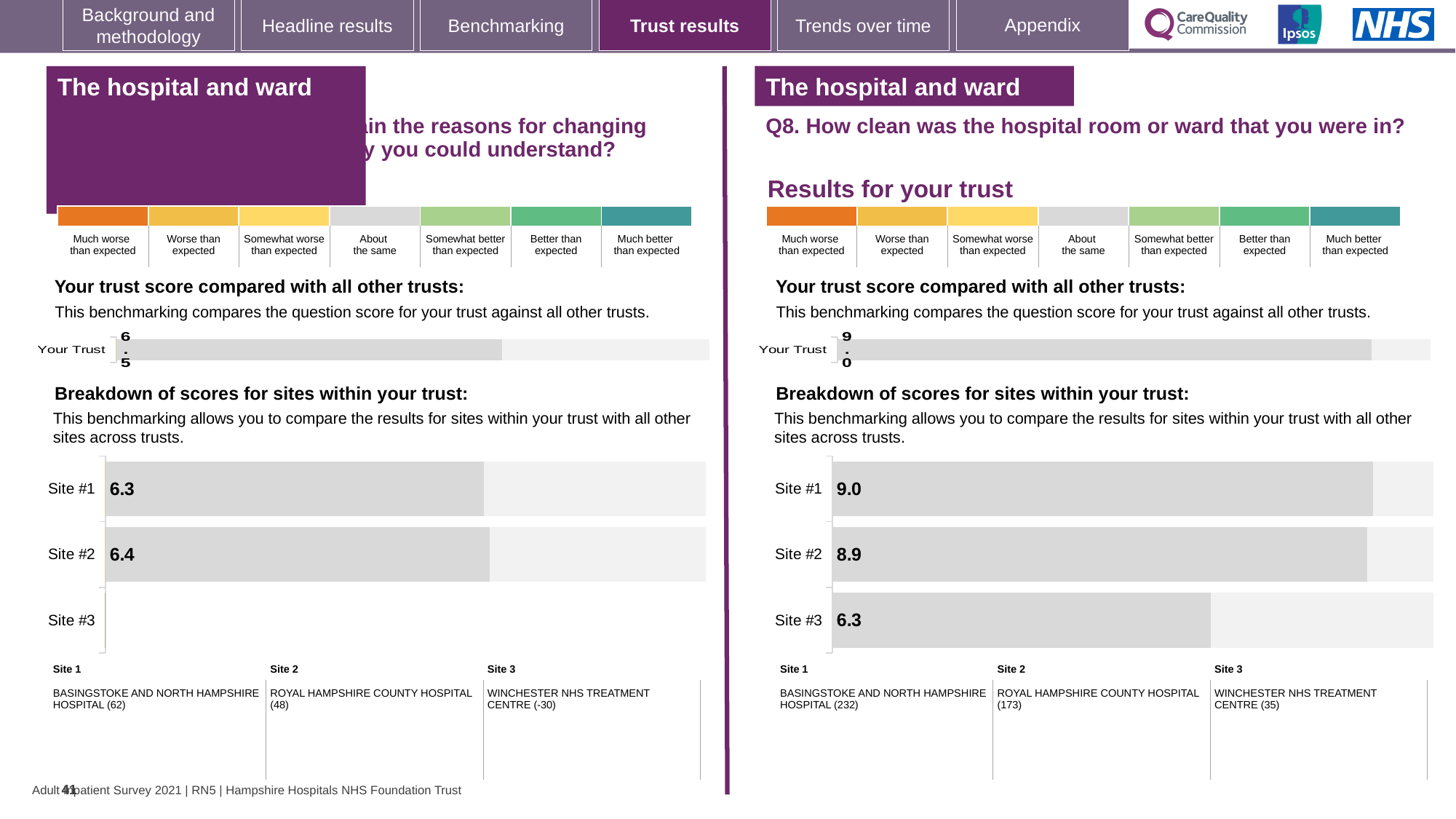
On the right-hand chart for Q8, what is the score for Site #2? 8.9 On the right-hand chart for Q8, what is the score for Site #3? 6.3 On the right-hand chart for Q8, which site has the lowest score? Site #3 On the right-hand chart for Q8, what is the difference between the scores for Site #1 and Site #3? 2.7 On the left-hand site breakdown chart, what is the score for Site #2? 6.4 What type of chart is used for the Q8 breakdown of scores for sites within your trust? Bar chart How many sites are listed in the right-hand Q8 site breakdown chart? 3 On the left-hand site breakdown chart, what is the score for Site #1? 6.3 On the right-hand Q8 'Your trust score compared with all other trusts' chart, what is the score shown for Your Trust? 9.0 On the right-hand chart for Q8 (How clean was the hospital room or ward that you were in?), what is the score for Site #1 in the breakdown of scores for sites within your trust? 9.0 On the left-hand site breakdown chart, which of Site #1 or Site #2 has the higher score? Site #2 On the left-hand 'Your trust score compared with all other trusts' chart, what is the score shown for Your Trust? 6.5